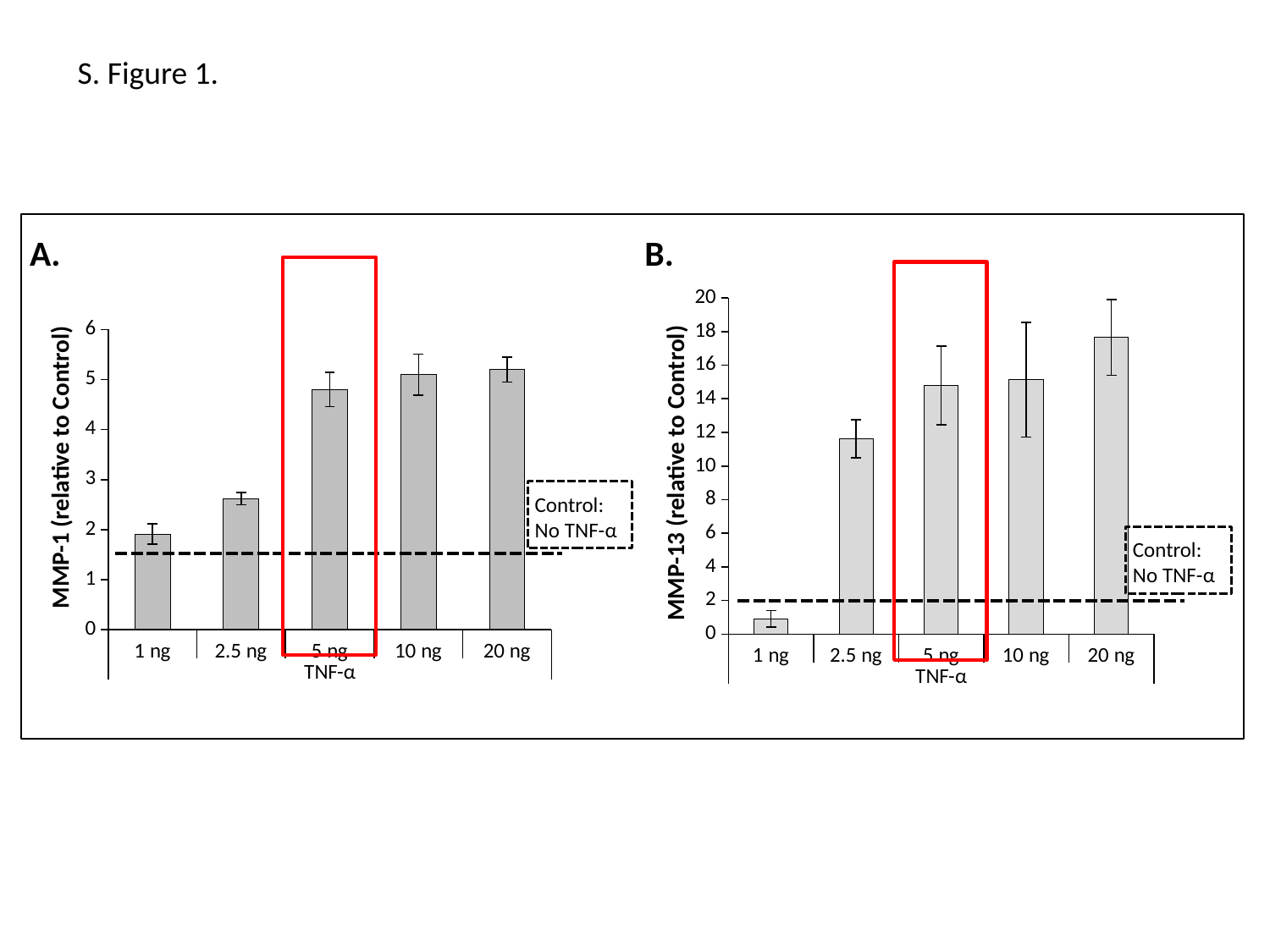
In chart B (MMP-13), is the value for 2.5 ng greater or less than 10? greater How many TNF-α dose categories are shown in chart A (MMP-1)? 5 In chart B (MMP-13), is the value for 1 ng greater or less than 2? less In chart A (MMP-1), is the value for 5 ng greater or less than 4? greater In chart A (MMP-1), which TNF-α dose has the lowest value? 1 ng In chart B (MMP-13), which TNF-α dose has the highest value? 20 ng In chart A (MMP-1), which is larger, the value for 2.5 ng or the value for 5 ng? 5 ng In chart B (MMP-13), what does the dashed horizontal line represent according to its label? Control: No TNF-α In chart B (MMP-13), which is larger, the value for 2.5 ng or the value for 20 ng? 20 ng What kind of chart is chart B (MMP-13)? Bar chart In chart B (MMP-13), which TNF-α dose has the lowest value? 1 ng